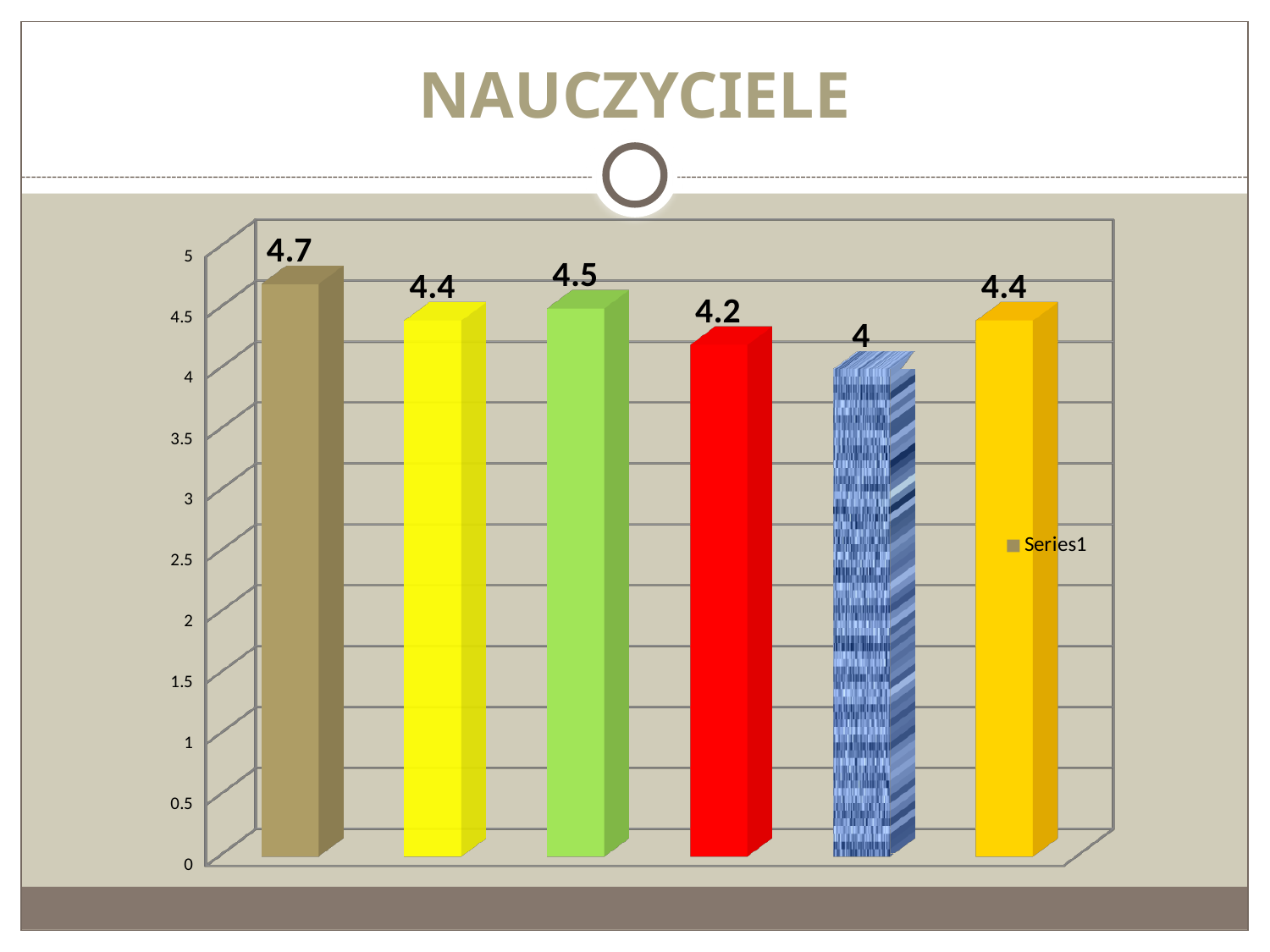
What is the value shown on the green bar? 4.5 What is the value shown on the red bar? 4.2 What is the value shown on the first (leftmost, brown) bar? 4.7 Which bar has the highest value? The first (brown) bar, 4.7 What is the difference between the highest bar value and the lowest bar value? 0.7 How many series does the legend list? 1 What is the value shown on the blue patterned bar? 4 Which is larger, the value of the green bar or the value of the red bar? The green bar (4.5) How many bars are plotted in the chart? 6 What type of chart is shown on the slide? Bar chart What is the title shown above the chart on the slide? NAUCZYCIELE Which bar has the lowest value? The fifth (blue patterned) bar, 4